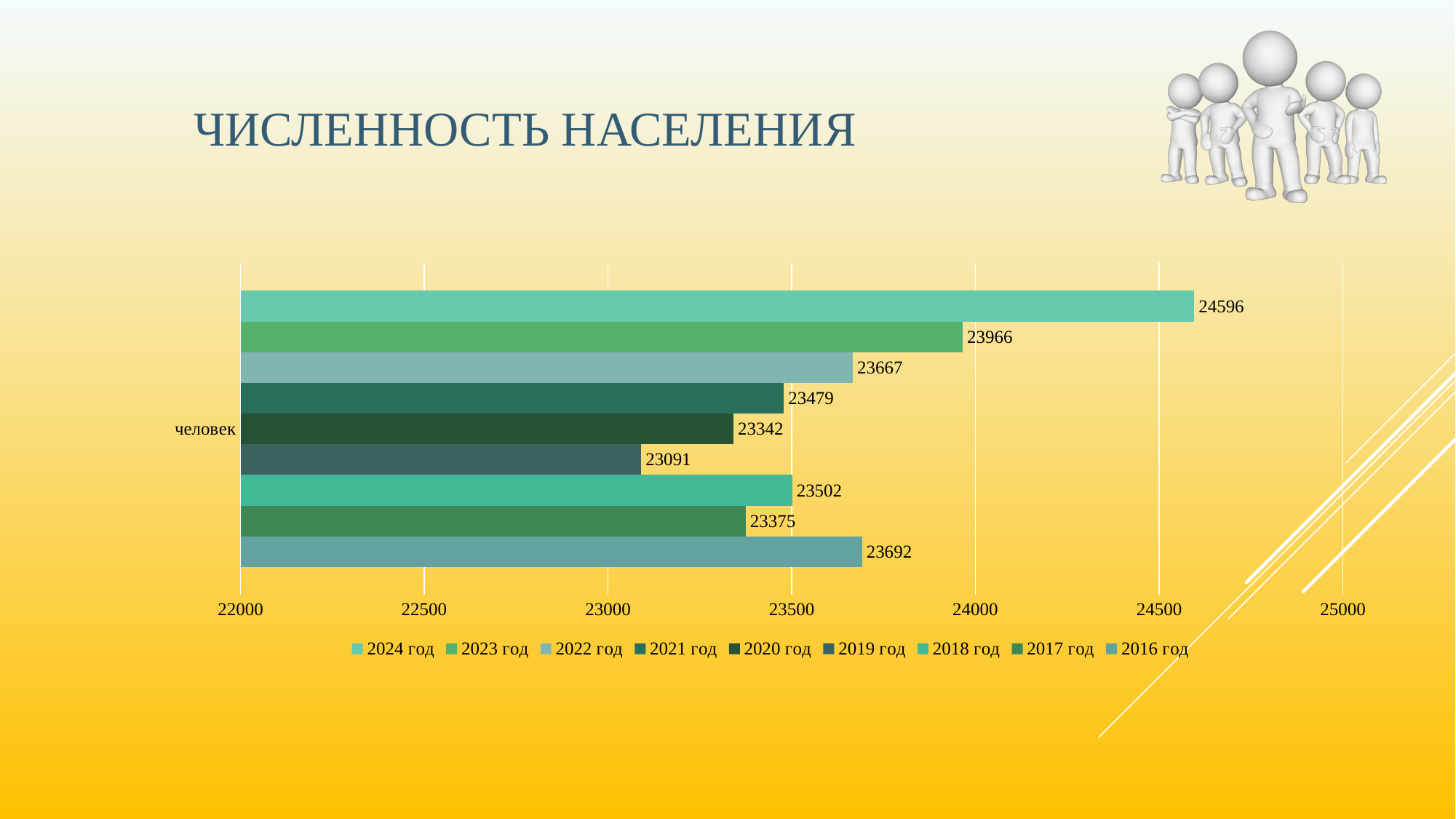
What is the title of the slide containing the chart? ЧИСЛЕННОСТЬ НАСЕЛЕНИЯ Which is larger, the value for 2018 год or the value for 2017 год? 2018 год What is the population value for 2016 год? 23692 Is the value for 2022 год greater or less than 23500? greater Which year has the highest population value? 2024 год What is the population value for 2019 год? 23091 Which year has the lowest population value? 2019 год What is the population value for 2024 год? 24596 What is the difference between the values for 2024 год and 2023 год? 630 How many series does the legend list? 9 What type of chart is shown on the slide? bar chart What is the difference between the values for 2016 год and 2019 год? 601